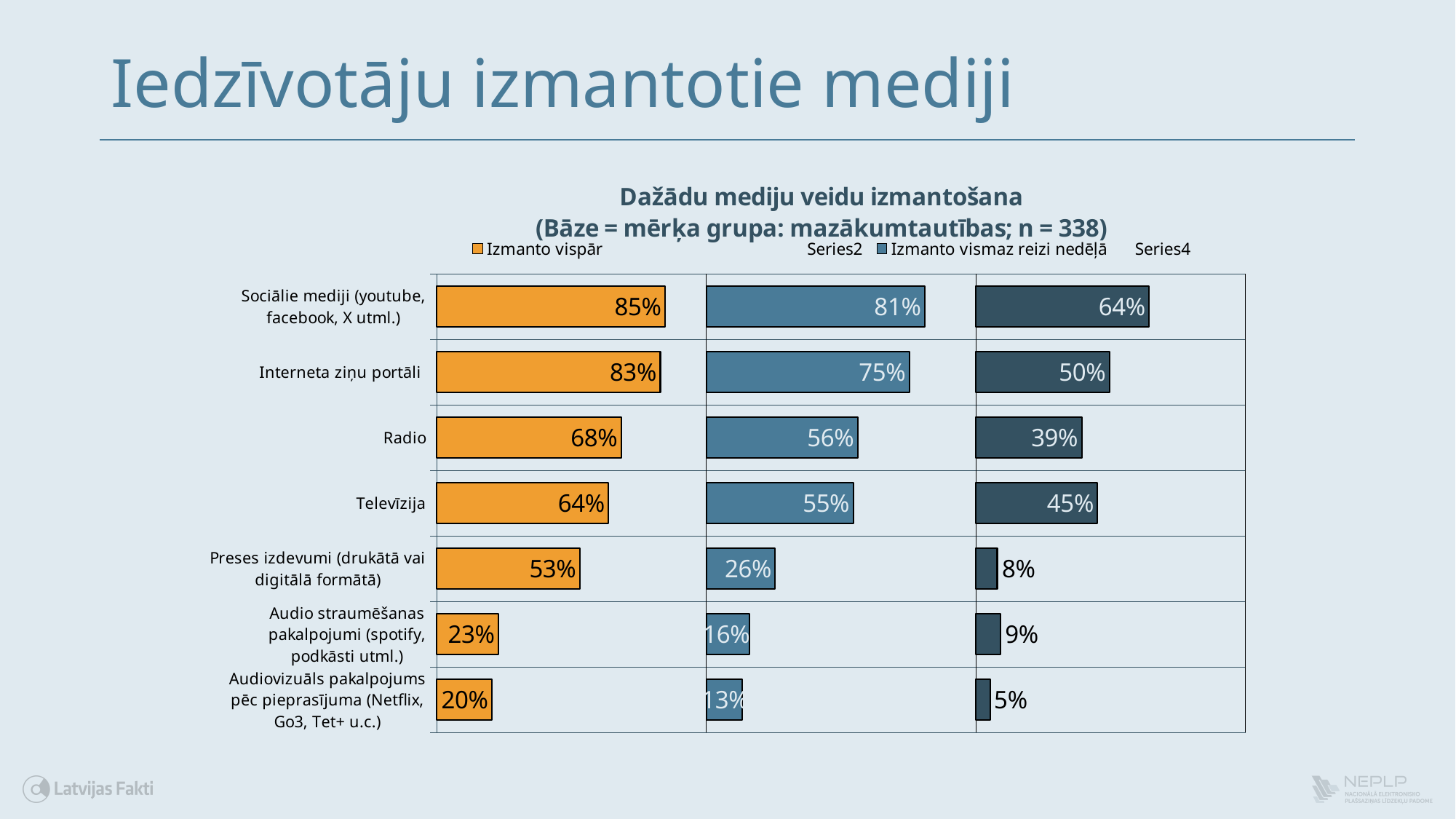
Which category has the highest 'Izmanto vispār' value? Sociālie mediji (youtube, facebook, X utml.) What is the title of the chart? Dažādu mediju veidu izmantošana (Bāze = mērķa grupa: mazākumtautības; n = 338) What type of chart is shown on the slide? Bar chart What value is shown on the rightmost (dark blue) bar for Radio? 39% How many media categories are shown in the chart? 7 Which category has the lowest 'Izmanto vispār' value? Audiovizuāls pakalpojums pēc pieprasījuma (Netflix, Go3, Tet+ u.c.) What is the 'Izmanto vispār' value for Televīzija? 64% How many series does the legend list? 4 What value is shown on the middle (blue) bar for Preses izdevumi (drukātā vai digitālā formātā)? 26% Which has a higher 'Izmanto vispār' value, Radio or Televīzija? Radio What is the difference between the 'Izmanto vispār' values for Sociālie mediji and Interneta ziņu portāli? 2 percentage points What is the 'Izmanto vispār' value for Radio? 68%